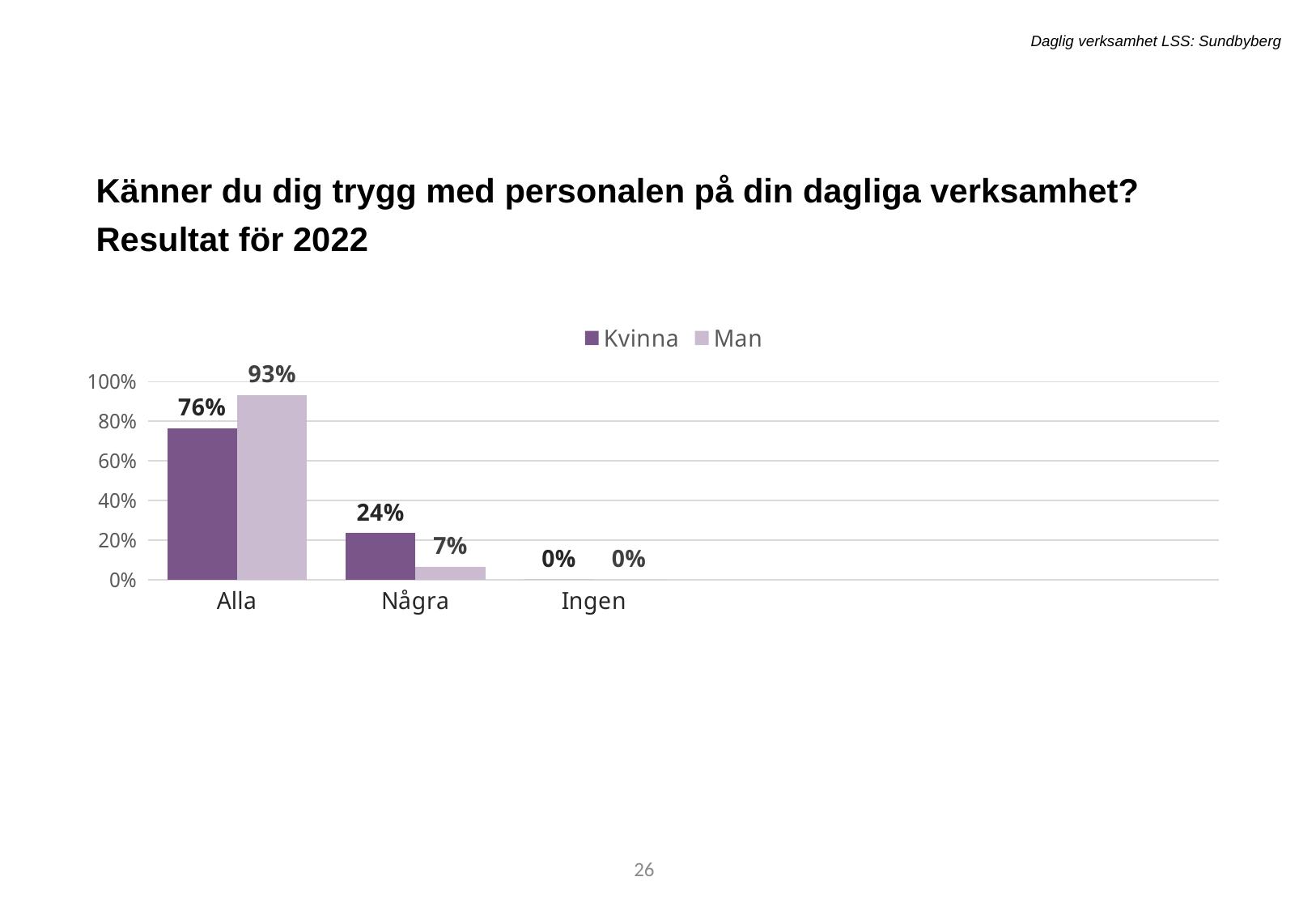
Do the Kvinna values rise or fall from Alla to Ingen? Fall Which category has the highest value for the Man series? Alla What is the value for Kvinna in the Några category? 24% How many series does the legend list? 2 What is the value for Kvinna in the Alla category? 76% Which is larger in the Några category, Kvinna or Man? Kvinna What kind of chart is shown on the slide? Bar chart What is the difference between the Man and Kvinna values in the Alla category? 17% Which category has the lowest value for the Kvinna series? Ingen What is the value for Man in the Alla category? 93% How many categories are shown on the x axis? 3 What is the value for Man in the Några category? 7%